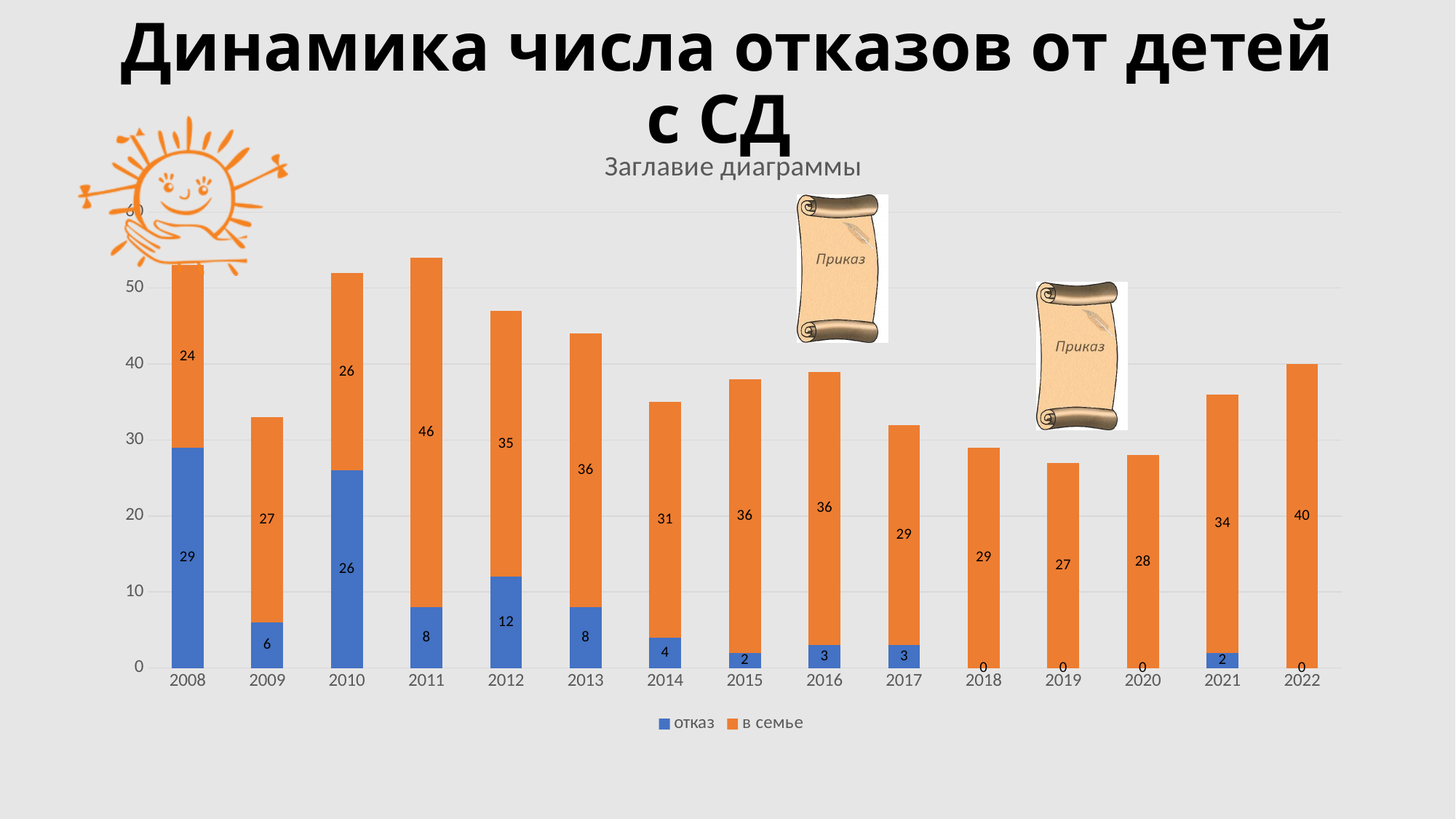
Does the 'отказ' series generally rise or fall from 2008 to 2022? fall What is the difference between the 'в семье' values for 2022 and 2019? 13 What is the total of the stacked bar for 2010? 52 How many years are shown on the x axis? 15 What is the value of the 'в семье' series for 2011? 46 What type of chart is shown on the slide? stacked bar chart Which year has the highest value for the 'в семье' series? 2011 Which year has the highest value for the 'отказ' series? 2008 What is the value of the 'в семье' series for 2022? 40 Which is larger: the 'отказ' value for 2012 or for 2013? 2012 How many series does the legend list? 2 What is the value of the 'отказ' series for 2008? 29